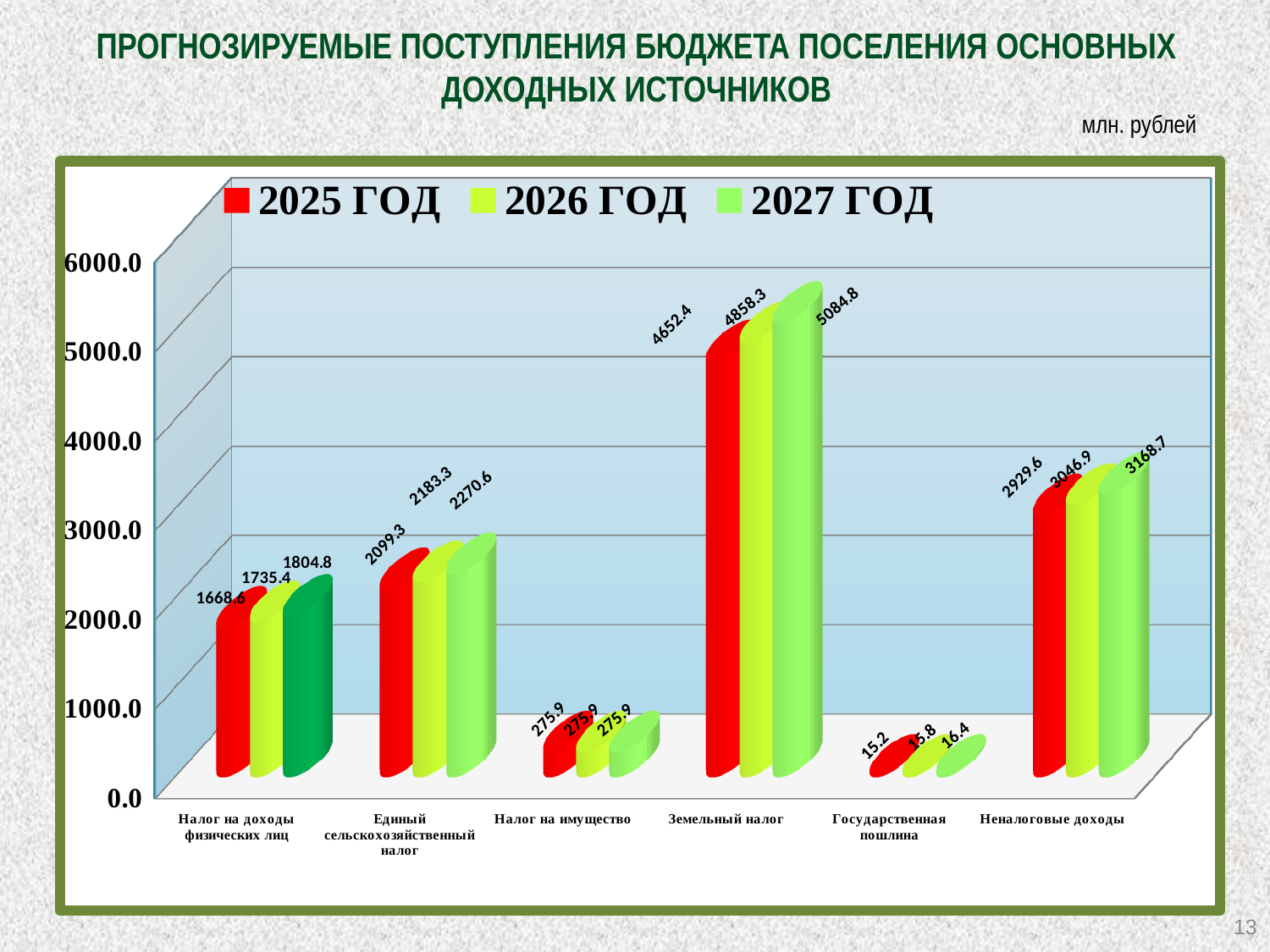
How many series does the legend list? 3 What is the difference between the 2027 ГОД and 2025 ГОД values for Земельный налог? 432.4 What is the value for Налог на доходы физических лиц in 2026 ГОД? 1735.4 Do the values for Налог на имущество change from 2025 ГОД to 2027 ГОД? No, they stay at 275.9 Is the 2025 ГОД value for Неналоговые доходы greater or less than 3000.0? less Which category has the lowest value in 2025 ГОД? Государственная пошлина What kind of chart is shown on the slide? bar chart What is the value for Земельный налог in 2025 ГОД? 4652.4 Which is larger: the 2026 ГОД value for Единый сельскохозяйственный налог or the 2026 ГОД value for Налог на доходы физических лиц? Единый сельскохозяйственный налог Which category has the highest value in 2027 ГОД? Земельный налог How many categories are shown on the x axis? 6 What is the value for Неналоговые доходы in 2027 ГОД? 3168.7